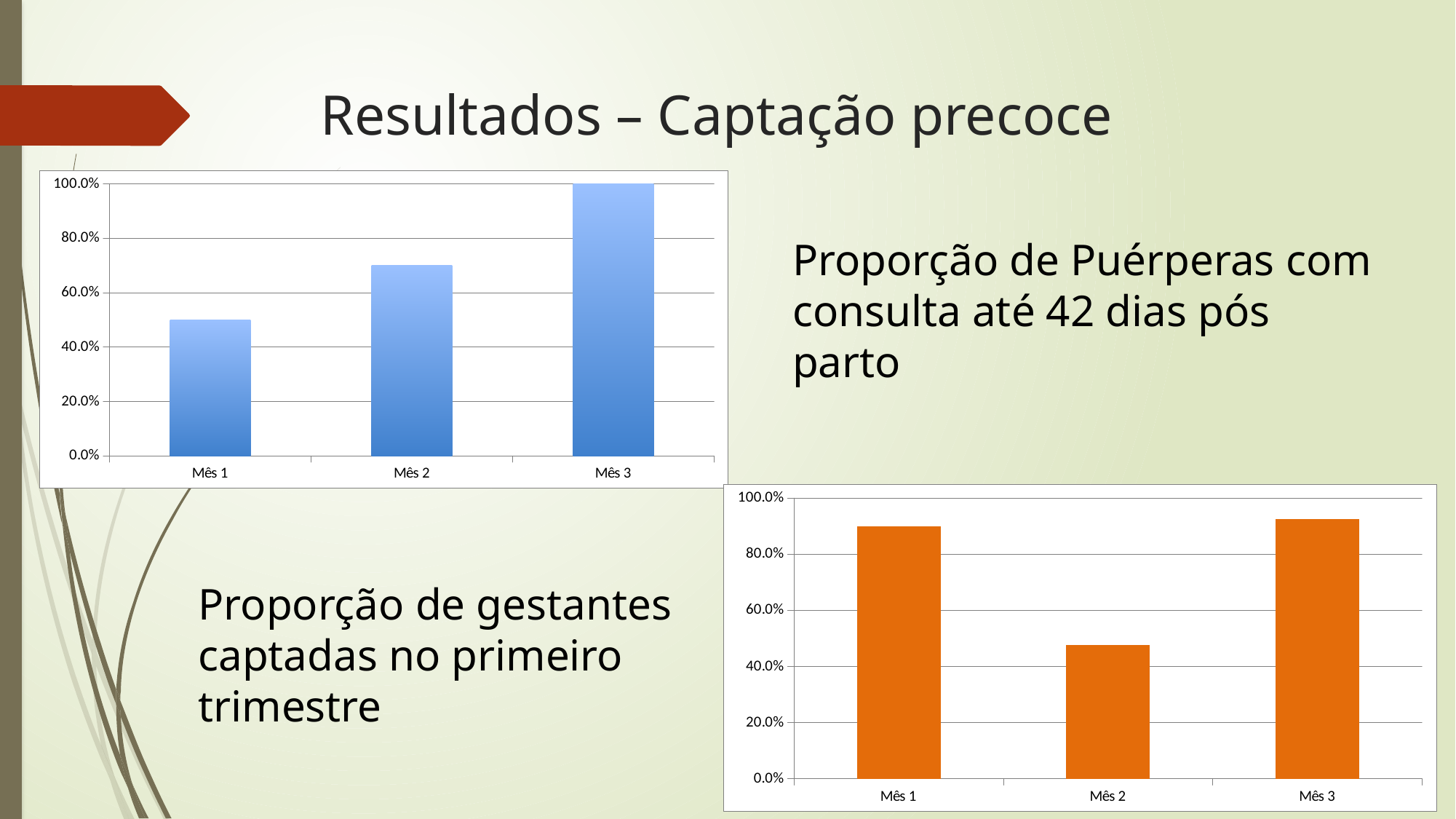
In the top-left chart, do the values rise or fall from Mês 1 to Mês 3? rise In the top-left chart, which month has the lowest value? Mês 1 In the top-left chart, which month has the highest value? Mês 3 In the top-left chart, what is the value for Mês 3? 100.0% In the bottom-right chart, which is larger, the value for Mês 1 or Mês 2? Mês 1 In the bottom-right chart, is the value for Mês 2 greater or less than 60.0%? less In the top-left chart, is the value for Mês 2 greater or less than 60.0%? greater In the bottom-right chart, which month has the lowest value? Mês 2 What kind of chart is the top-left chart? bar chart How many categories does the top-left chart show? 3 In the bottom-right chart, is the value for Mês 1 greater or less than 80.0%? greater What colour are the bars in the bottom-right chart? orange